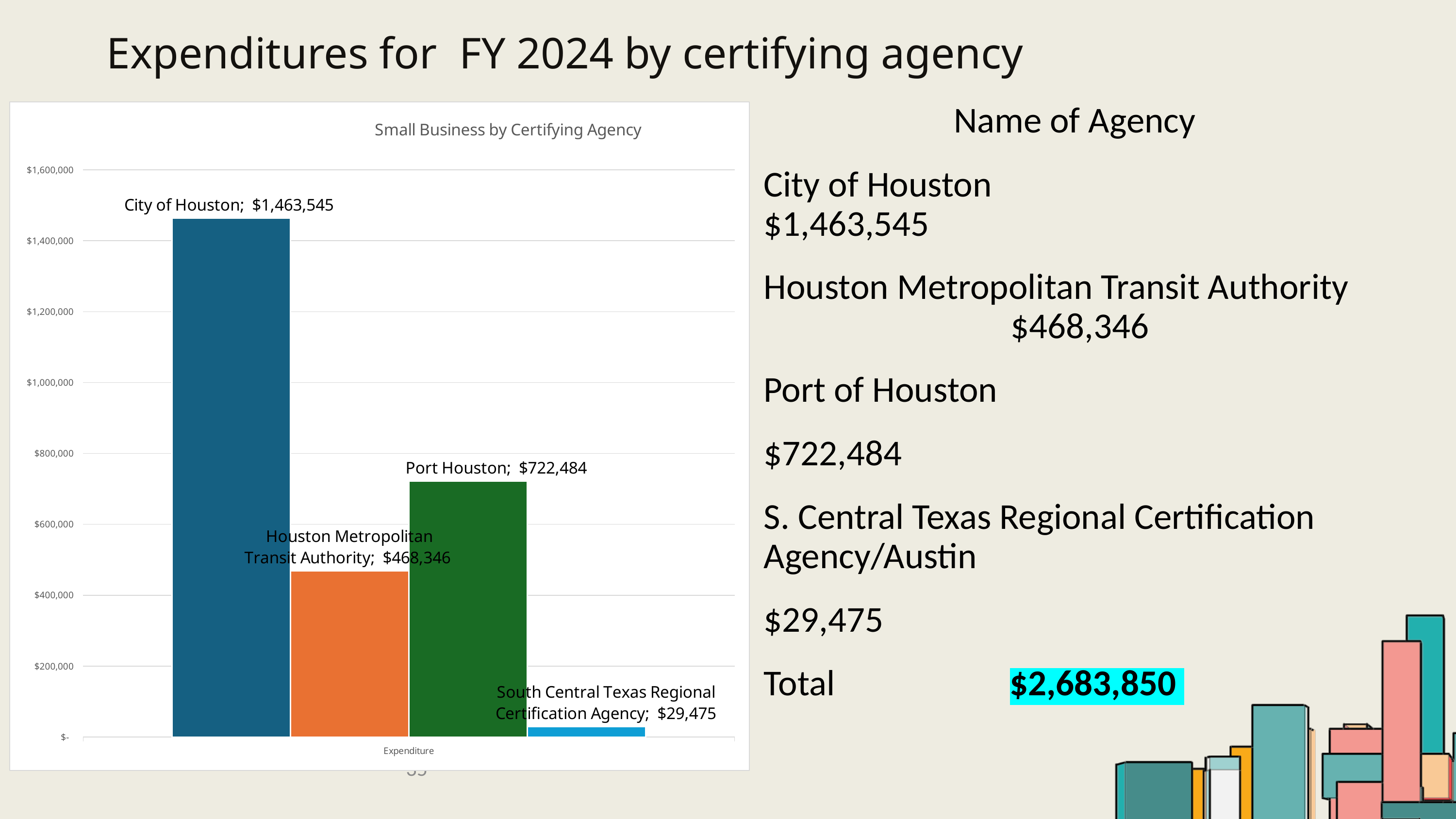
Which has a larger expenditure, Port Houston or Houston Metropolitan Transit Authority? Port Houston How many certifying agencies are shown in the chart? 4 What is the difference between the expenditures for City of Houston and Port Houston? $741,061 What is the expenditure for Houston Metropolitan Transit Authority? $468,346 What is the difference between the expenditures for Port Houston and Houston Metropolitan Transit Authority? $254,138 What is the expenditure for Port Houston? $722,484 What is the expenditure for South Central Texas Regional Certification Agency? $29,475 Which certifying agency has the highest expenditure? City of Houston What is the title of the chart? Small Business by Certifying Agency Which certifying agency has the lowest expenditure? South Central Texas Regional Certification Agency What kind of chart is shown on the slide? Bar chart What is the expenditure for City of Houston? $1,463,545